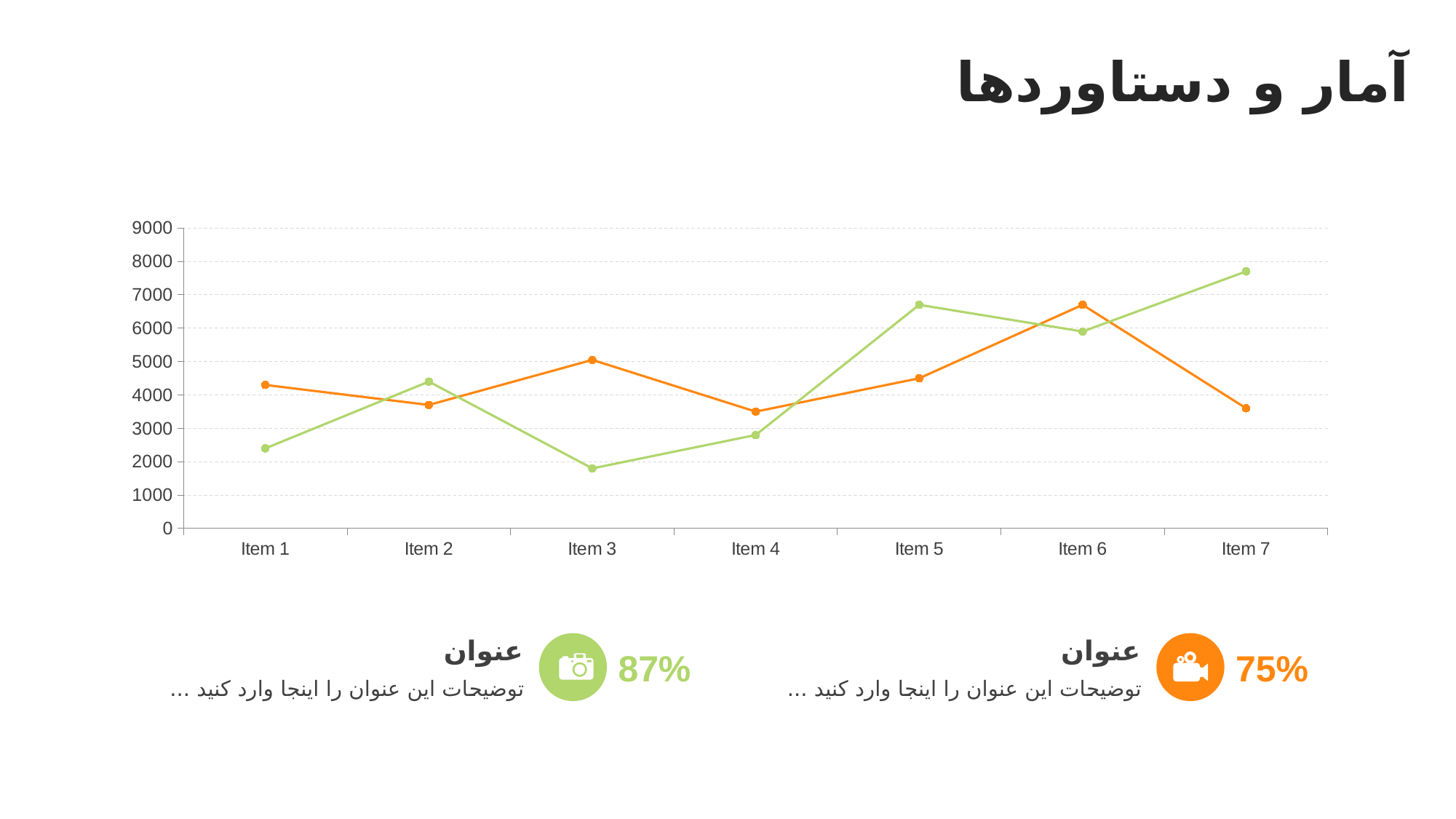
Is the value of the green line at Item 3 greater or less than 2000? less Is the value of the orange line at Item 1 greater or less than 4000? greater How many categories are shown on the x axis of the chart? 7 How many lines are plotted on the chart? 2 What kind of chart is shown on the slide? line chart Is the value of the green line at Item 7 greater or less than 7000? greater At Item 1, which line has the higher value, the green line or the orange line? the orange line At which item does the orange line reach its highest value? Item 6 At which item does the green line reach its lowest value? Item 3 At Item 5, which line has the higher value, the green line or the orange line? the green line Does the orange line rise or fall from Item 6 to Item 7? fall At which item does the green line reach its highest value? Item 7